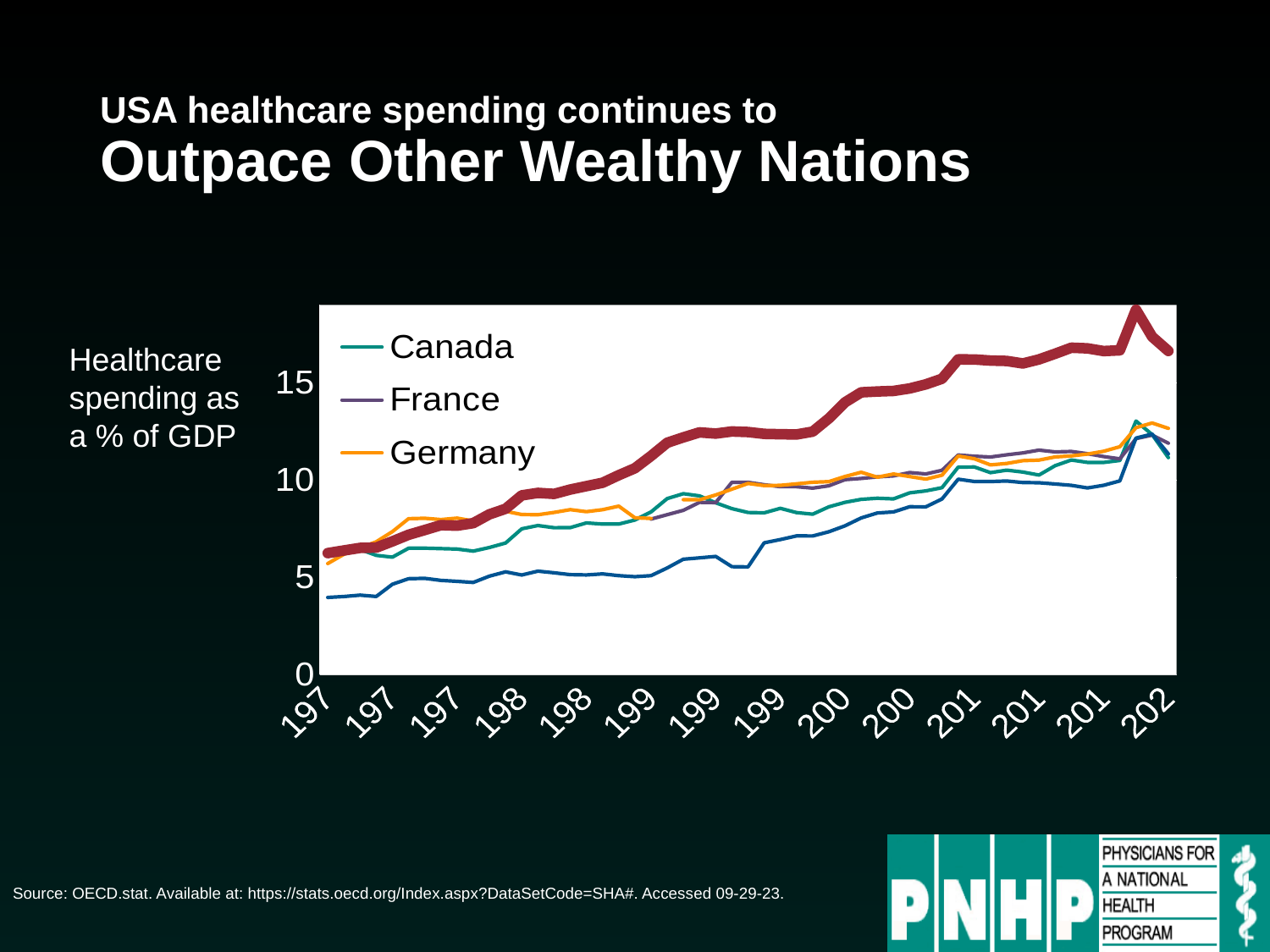
What quantity does the y axis of the chart represent? Healthcare spending as a % of GDP How many lines are plotted on the chart? 5 How many series does the chart's legend list? 3 At the right end of the chart, is the value for France greater or less than 10? greater Over the full span of the x axis, does the Canada line rise or fall overall? rise At the right end of the chart, is the value for Canada greater or less than 10? greater At its highest point, is the thick red line greater or less than 15? greater Over the full span of the x axis, does the Germany line rise or fall overall? rise Which countries are named in the chart's legend? Canada, France, Germany What kind of chart is shown on the slide? line chart